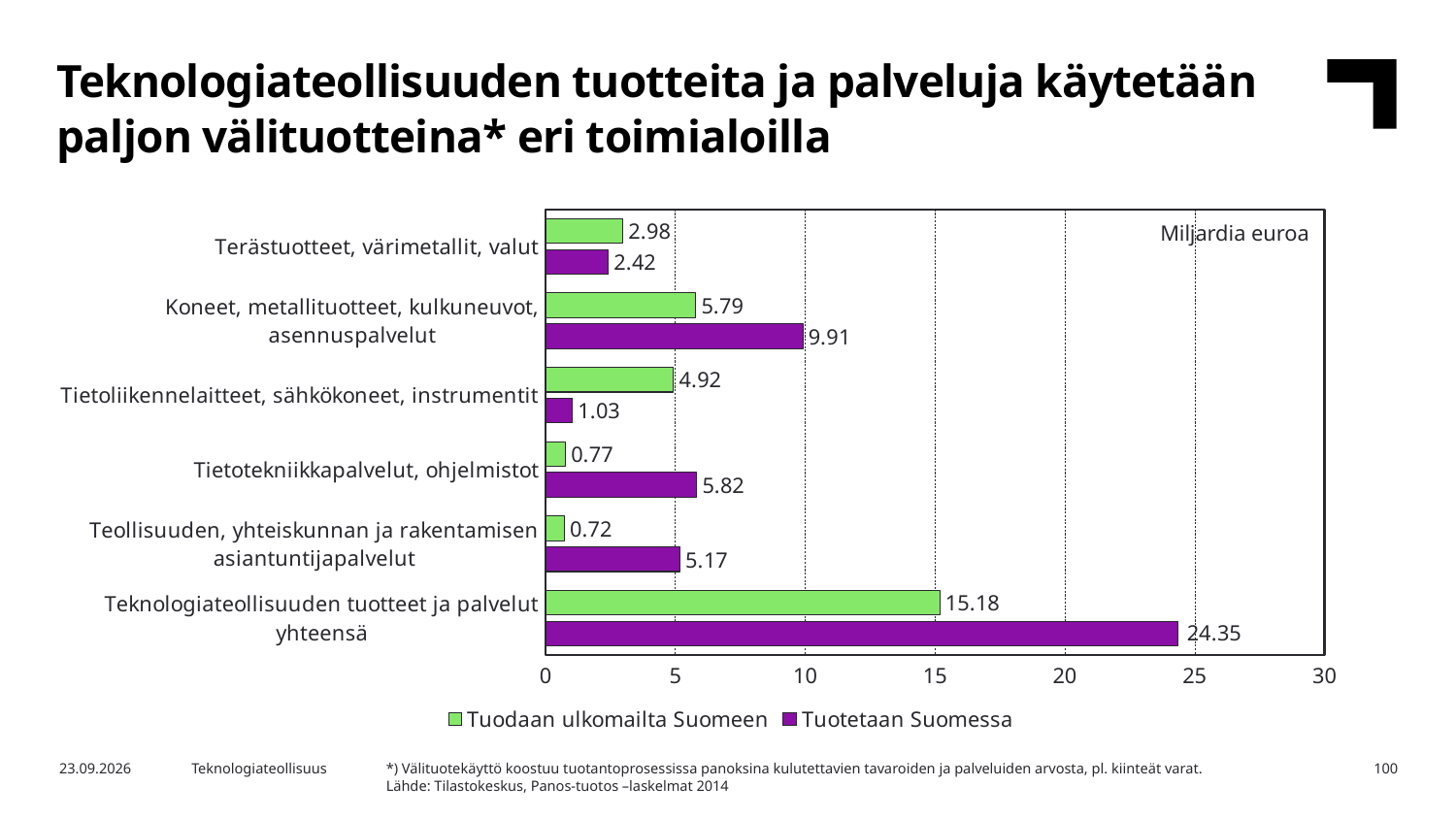
For "Terästuotteet, värimetallit, valut", which is larger: "Tuodaan ulkomailta Suomeen" or "Tuotetaan Suomessa"? Tuodaan ulkomailta Suomeen What is the value of "Tuodaan ulkomailta Suomeen" for "Tietoliikennelaitteet, sähkökoneet, instrumentit"? 4.92 Is the value of "Tuotetaan Suomessa" for "Teknologiateollisuuden tuotteet ja palvelut yhteensä" greater or less than 20? greater What kind of chart is shown on the slide? bar chart How many series does the legend list? 2 What is the difference between "Tuotetaan Suomessa" and "Tuodaan ulkomailta Suomeen" for "Teknologiateollisuuden tuotteet ja palvelut yhteensä"? 9.17 What is the value of "Tuotetaan Suomessa" for "Tietotekniikkapalvelut, ohjelmistot"? 5.82 How many categories are shown on the chart? 6 What unit is indicated in the chart area? Miljardia euroa What is the value of "Tuotetaan Suomessa" for "Koneet, metallituotteet, kulkuneuvot, asennuspalvelut"? 9.91 Which category has the highest value for "Tuodaan ulkomailta Suomeen"? Teknologiateollisuuden tuotteet ja palvelut yhteensä Which category has the lowest value for "Tuotetaan Suomessa"? Tietoliikennelaitteet, sähkökoneet, instrumentit